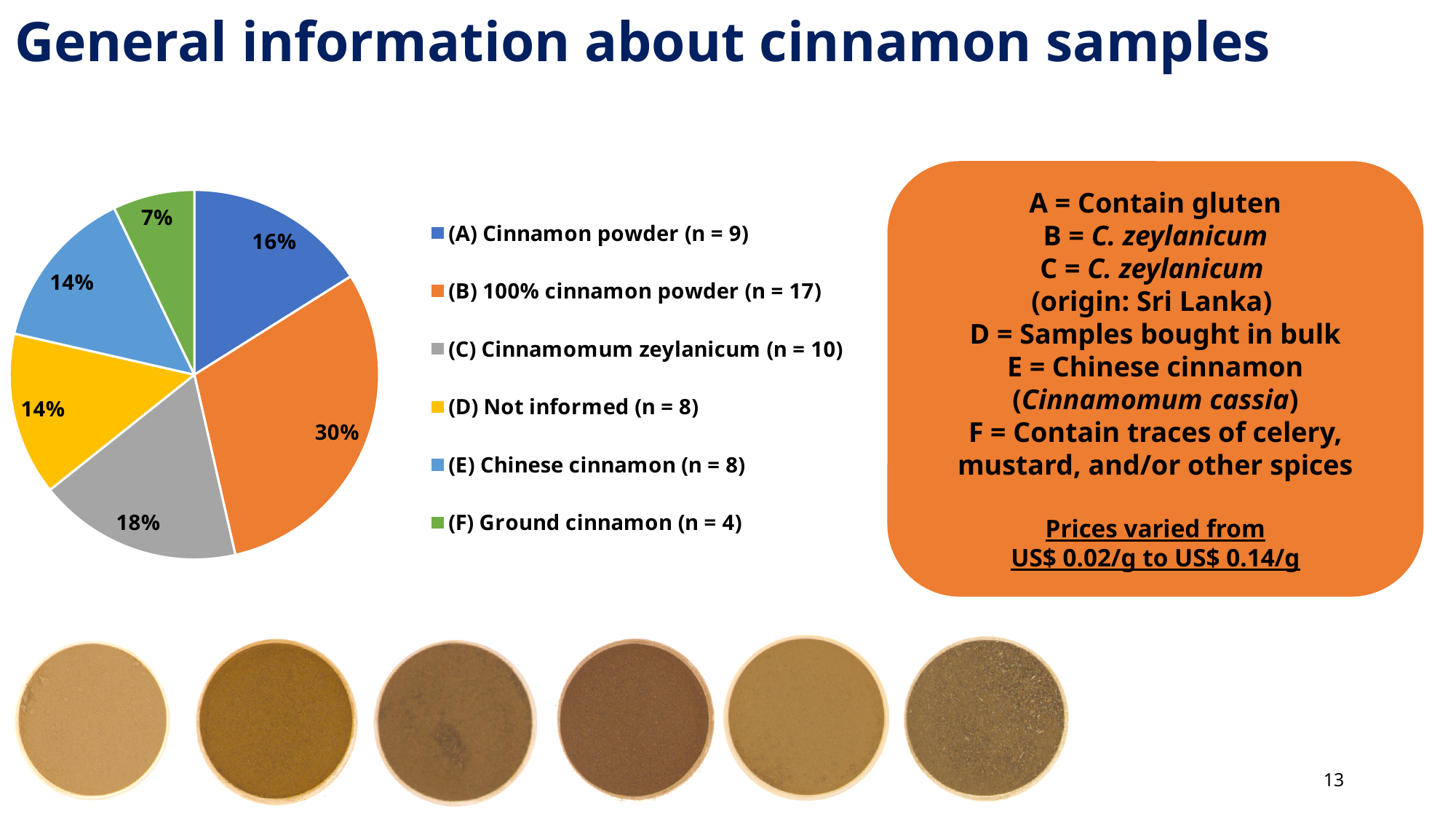
What share of the pie does (B) 100% cinnamon powder represent? 30% According to the legend, how many samples (n) are in category (B) 100% cinnamon powder? 17 Which category has the smallest slice of the pie? (F) Ground cinnamon What share of the pie does (A) Cinnamon powder represent? 16% Which category has the largest slice of the pie? (B) 100% cinnamon powder What kind of chart is shown on the slide? pie chart How many categories does the pie chart show? 6 Which slice is larger, (C) Cinnamomum zeylanicum or (E) Chinese cinnamon? (C) Cinnamomum zeylanicum What share of the pie does (F) Ground cinnamon represent? 7% What is the difference in percentage points between the (B) 100% cinnamon powder slice and the (A) Cinnamon powder slice? 14% What colour is the slice for (D) Not informed? yellow